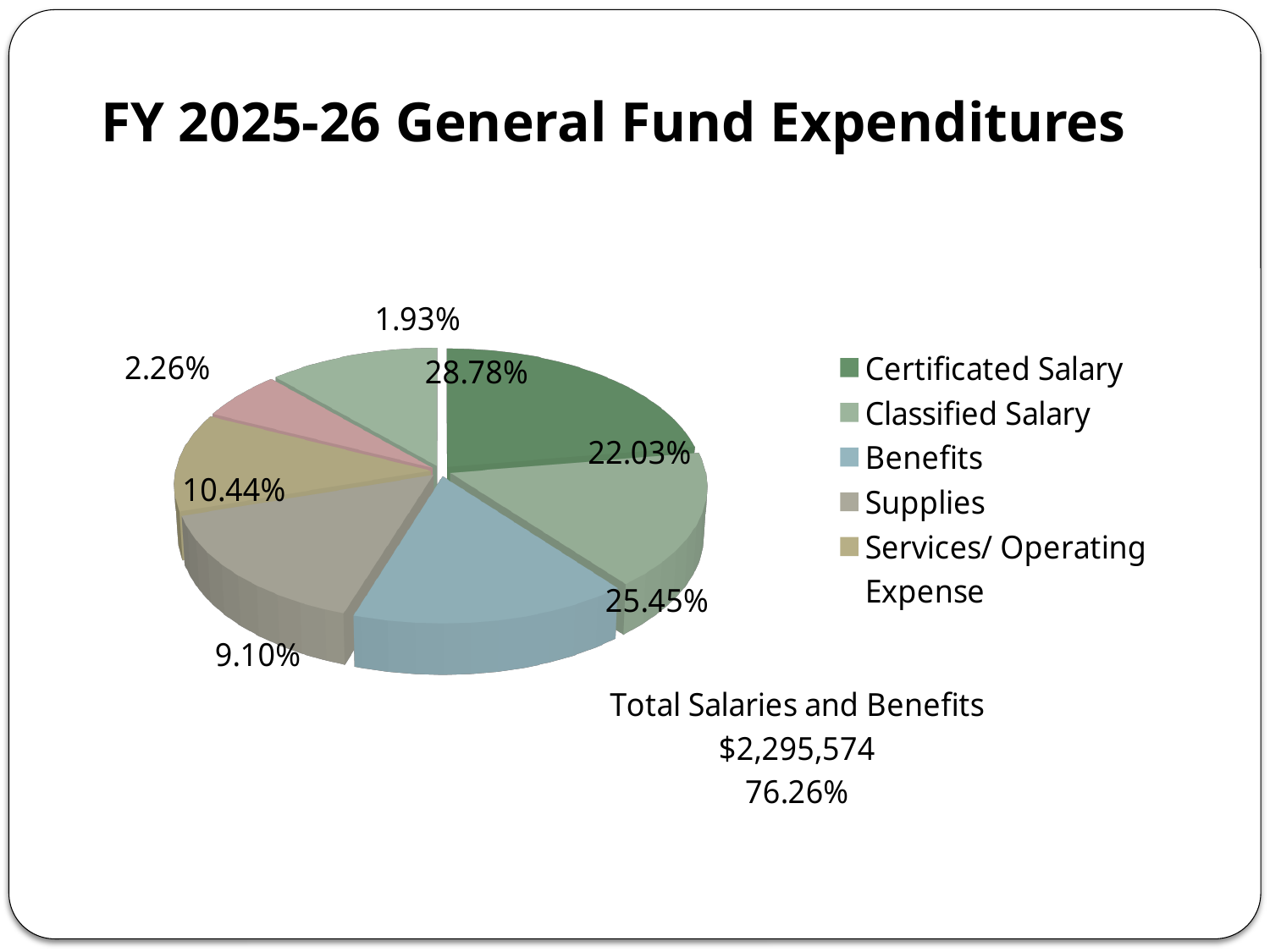
What is the smallest percentage label shown on the pie chart? 1.93% What is the title of the slide? FY 2025-26 General Fund Expenditures What percentage of general fund expenditures is Services/ Operating Expense? 10.44% Which is larger, the Benefits share or the Classified Salary share? Benefits What percentage of general fund expenditures is Certificated Salary? 28.78% What percentage of general fund expenditures is Classified Salary? 22.03% What percentage of general fund expenditures is Benefits? 25.45% What percentage of general fund expenditures is Supplies? 9.10% Which legend category has the largest share of the pie? Certificated Salary What kind of chart is shown on the slide? Pie chart What is the difference in percentage points between Certificated Salary and Classified Salary? 6.75% How many entries does the legend list? 5